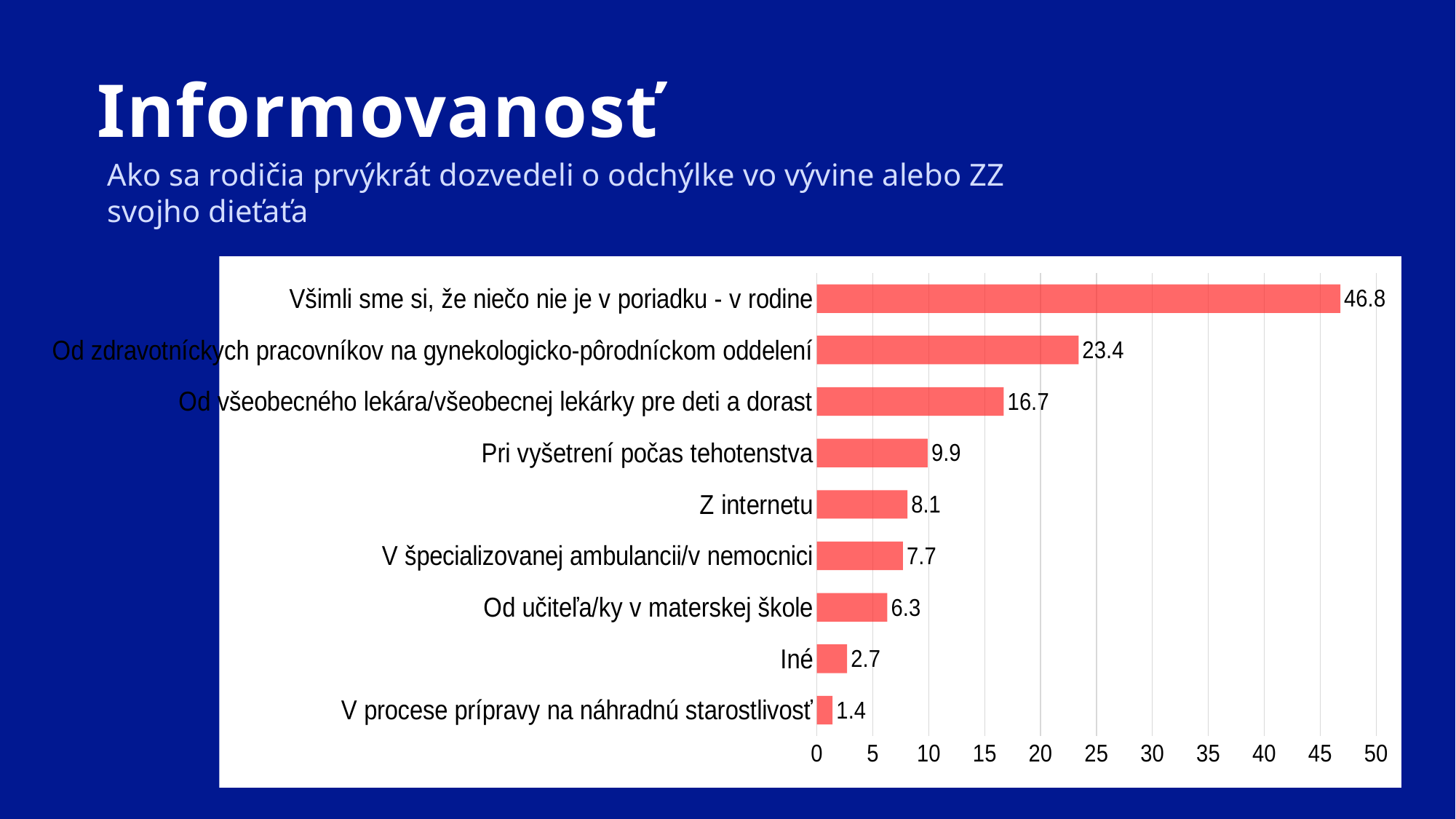
What is the difference between the values for "Všimli sme si, že niečo nie je v poriadku - v rodine" and "Od zdravotníckych pracovníkov na gynekologicko-pôrodníckom oddelení"? 23.4 What is the value for "Pri vyšetrení počas tehotenstva"? 9.9 What is the value for "Iné"? 2.7 What kind of chart is shown on the slide? bar chart Which is larger: the value for "Od všeobecného lekára/všeobecnej lekárky pre deti a dorast" or the value for "Pri vyšetrení počas tehotenstva"? Od všeobecného lekára/všeobecnej lekárky pre deti a dorast How many categories are shown in the chart? 9 Is the value for "Od zdravotníckych pracovníkov na gynekologicko-pôrodníckom oddelení" greater or less than 20? greater Which category has the highest value? Všimli sme si, že niečo nie je v poriadku - v rodine What is the value for "Od učiteľa/ky v materskej škole"? 6.3 Which category has the lowest value? V procese prípravy na náhradnú starostlivosť What is the difference between the values for "Z internetu" and "V špecializovanej ambulancii/v nemocnici"? 0.4 What is the value for "Z internetu"? 8.1